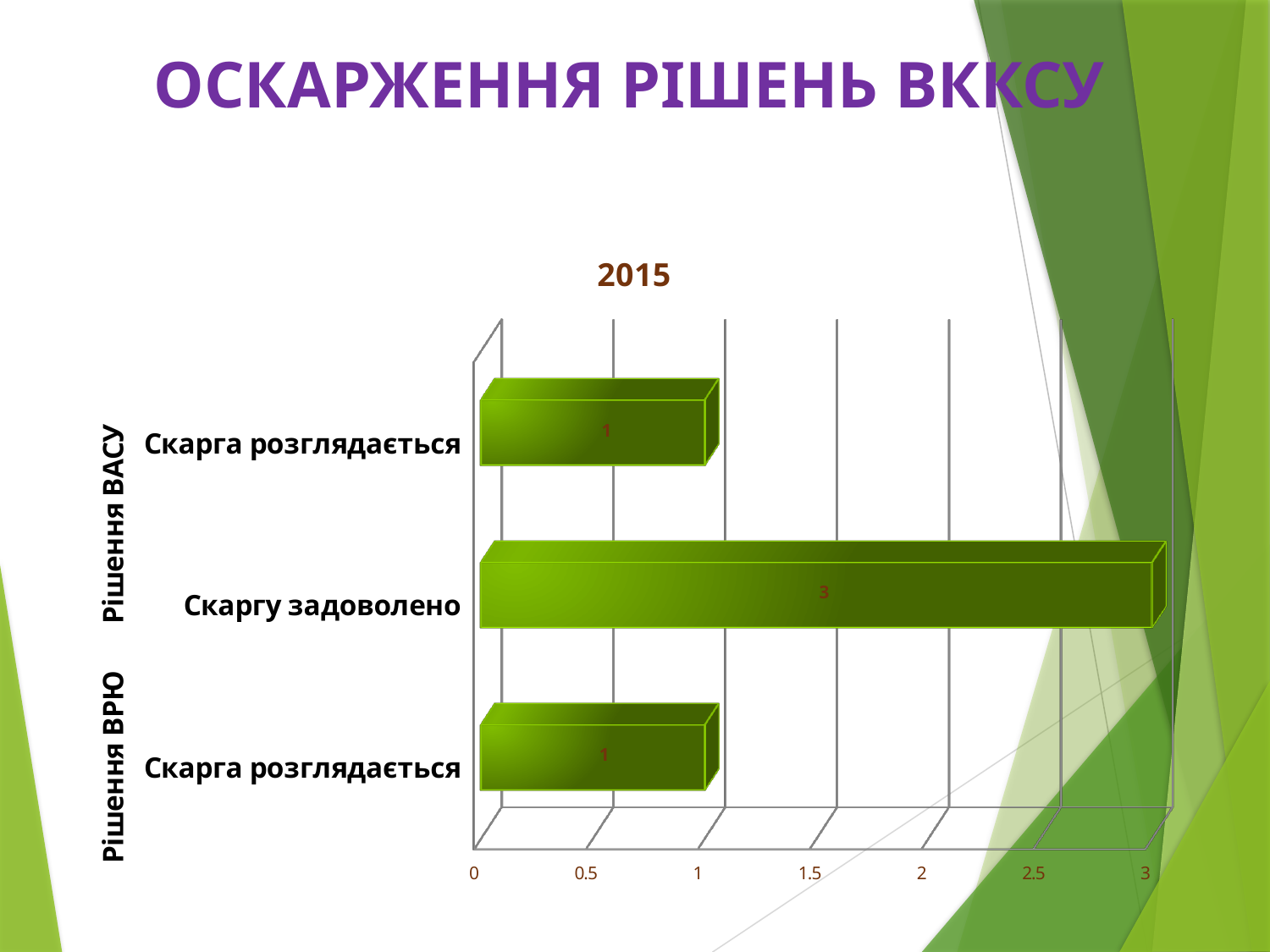
How many bars are plotted in the chart? 3 Which category has the highest value? Скаргу задоволено What is the value of the top bar, "Скарга розглядається"? 1 What is the value for "Скаргу задоволено"? 3 What is the title of the chart? 2015 What is the maximum value shown on the horizontal axis? 3 Which is larger: the value for "Скаргу задоволено" or the value of the bottom "Скарга розглядається" bar? Скаргу задоволено What is the difference between the value for "Скаргу задоволено" and the value of the top "Скарга розглядається" bar? 2 What is the value of the bottom bar, "Скарга розглядається"? 1 Is the value for "Скаргу задоволено" greater or less than 2? greater How many bars have a value of 1? 2 What kind of chart is shown on the slide? bar chart